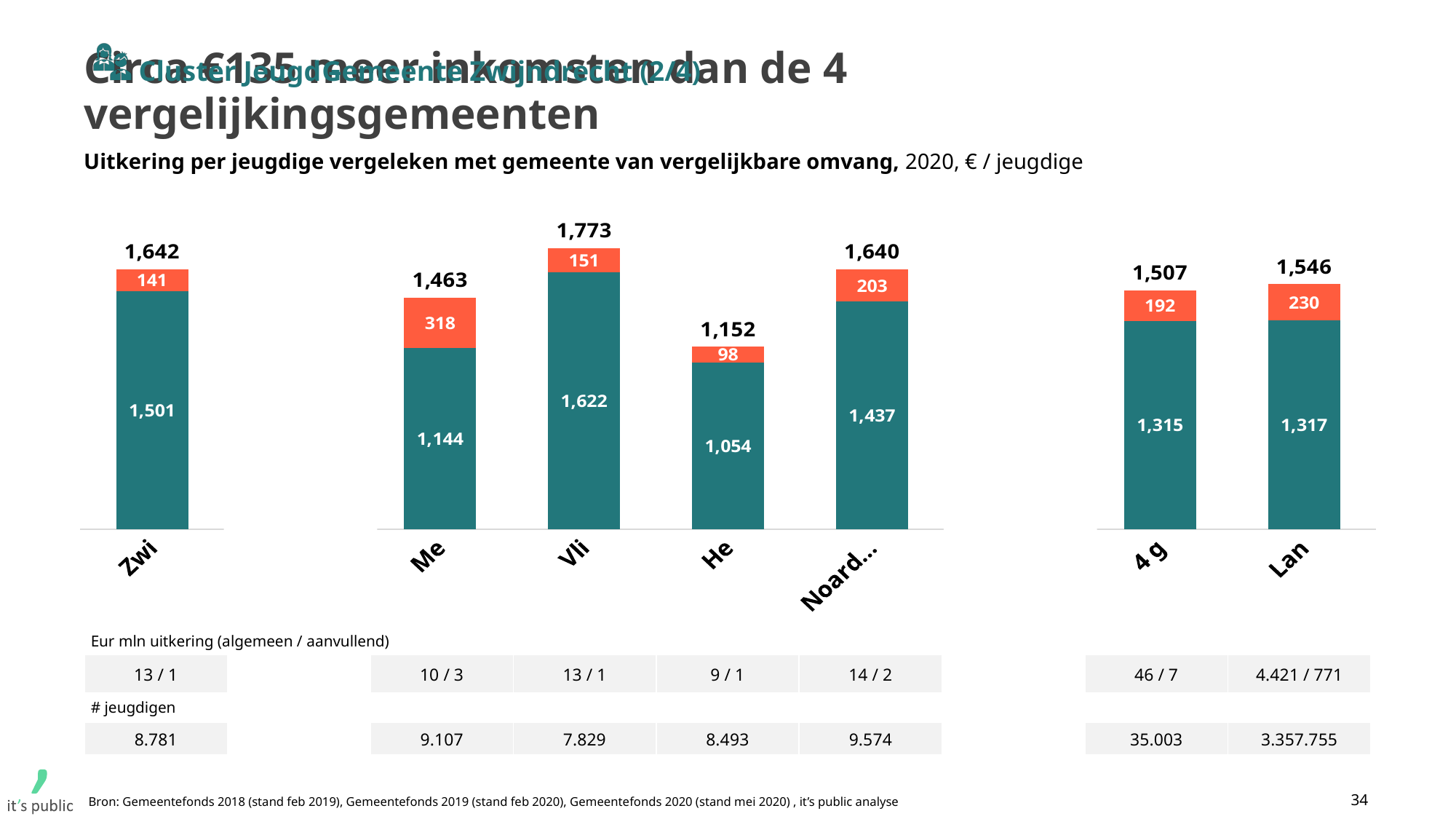
In the middle chart, what is the value of the teal (lower) segment for He? 1,054 How many categories are plotted in the middle chart? 4 In the middle chart, what is the difference between the totals for Vli and Me? 310 In the left chart, what is the value of the teal (lower) segment for Zwi? 1,501 In the middle chart, which category has the highest total? Vli In the middle chart, what is the total shown above the bar for Vli? 1,773 In the right chart, what is the value of the orange (upper) segment for Lan? 230 In the middle chart, which category has the lowest total? He What kind of chart is shown on the slide? bar chart In the middle chart, what is the value of the orange (upper) segment for Me? 318 In the right chart, which has the larger total, 4 g or Lan? Lan What is the difference between the total for Zwi in the left chart and the total for He in the middle chart? 490